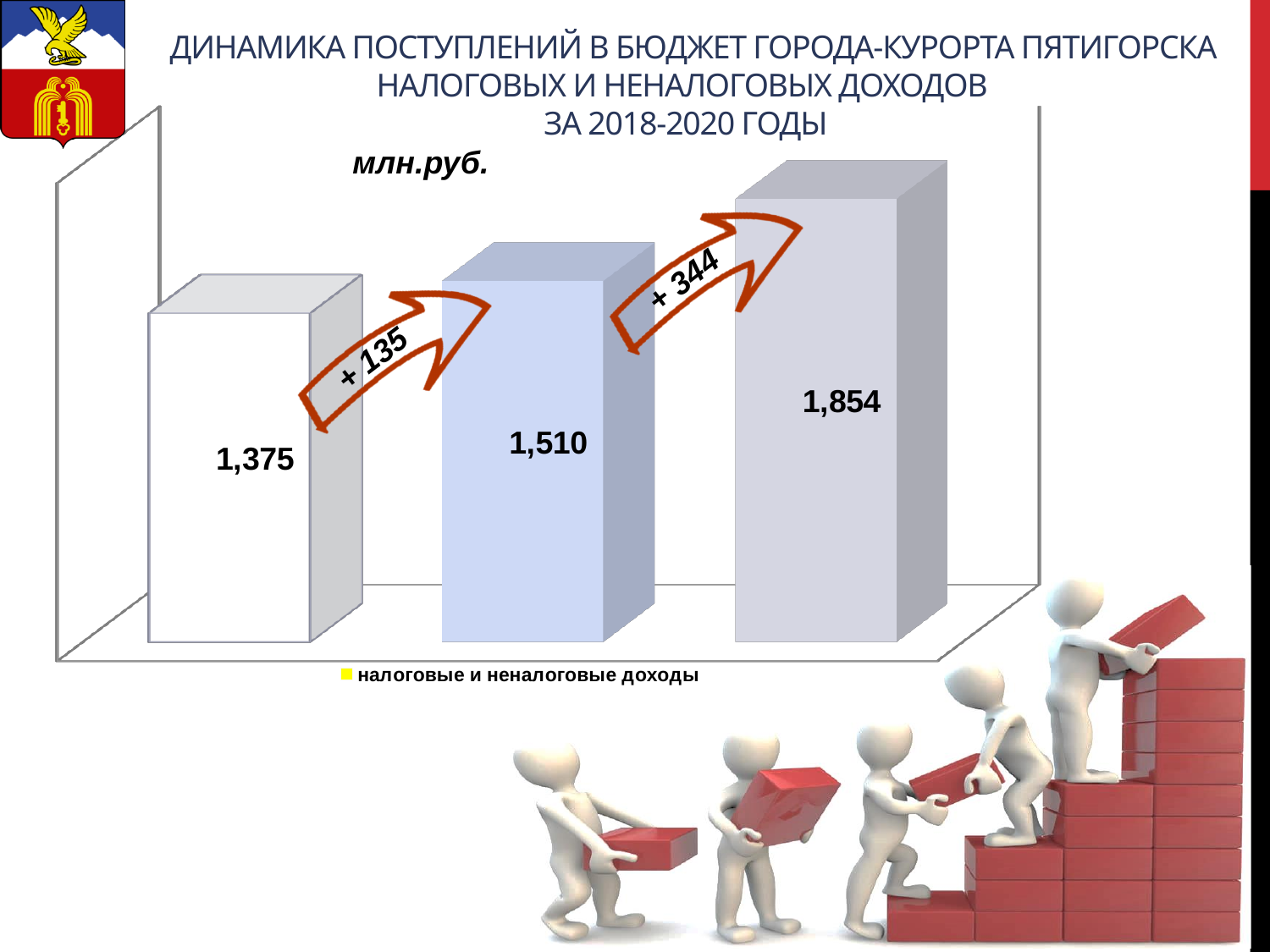
What is the difference between the rightmost bar and the leftmost bar? 479 By how much does the rightmost bar exceed the middle bar? 344 What kind of chart is shown on the slide? Bar chart Which bar has the highest value? The rightmost (third) bar, 1,854 What is the value shown on the middle bar? 1,510 How many series does the legend list? 1 How many bars are plotted on the chart? 3 By how much does the middle bar exceed the leftmost bar? 135 Which is larger, the middle bar or the leftmost bar? The middle bar (1,510) What is the value shown on the rightmost bar? 1,854 Which bar has the lowest value? The leftmost (first) bar, 1,375 What is the value shown on the leftmost bar? 1,375